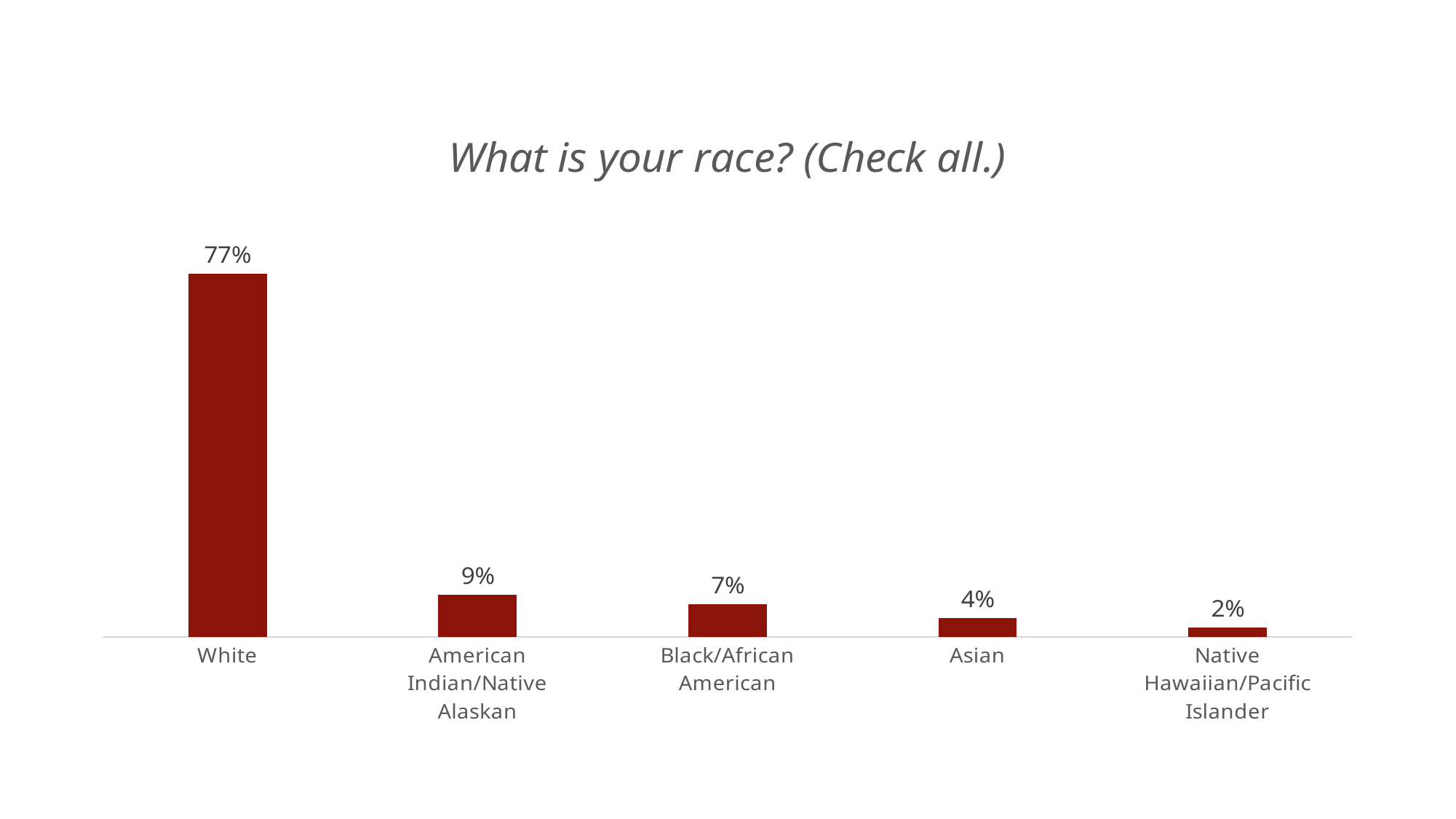
Which category has the highest value? White What is the value for American Indian/Native Alaskan? 9% Which is larger, the value for Black/African American or the value for Asian? Black/African American What is the title of the chart? What is your race? (Check all.) What is the value for White? 77% What is the value for Asian? 4% What kind of chart is shown on the slide? Bar chart What is the value for Black/African American? 7% How many categories are shown in the chart? 5 What is the value for Native Hawaiian/Pacific Islander? 2% Which category has the lowest value? Native Hawaiian/Pacific Islander What is the difference between the values for White and American Indian/Native Alaskan? 68%